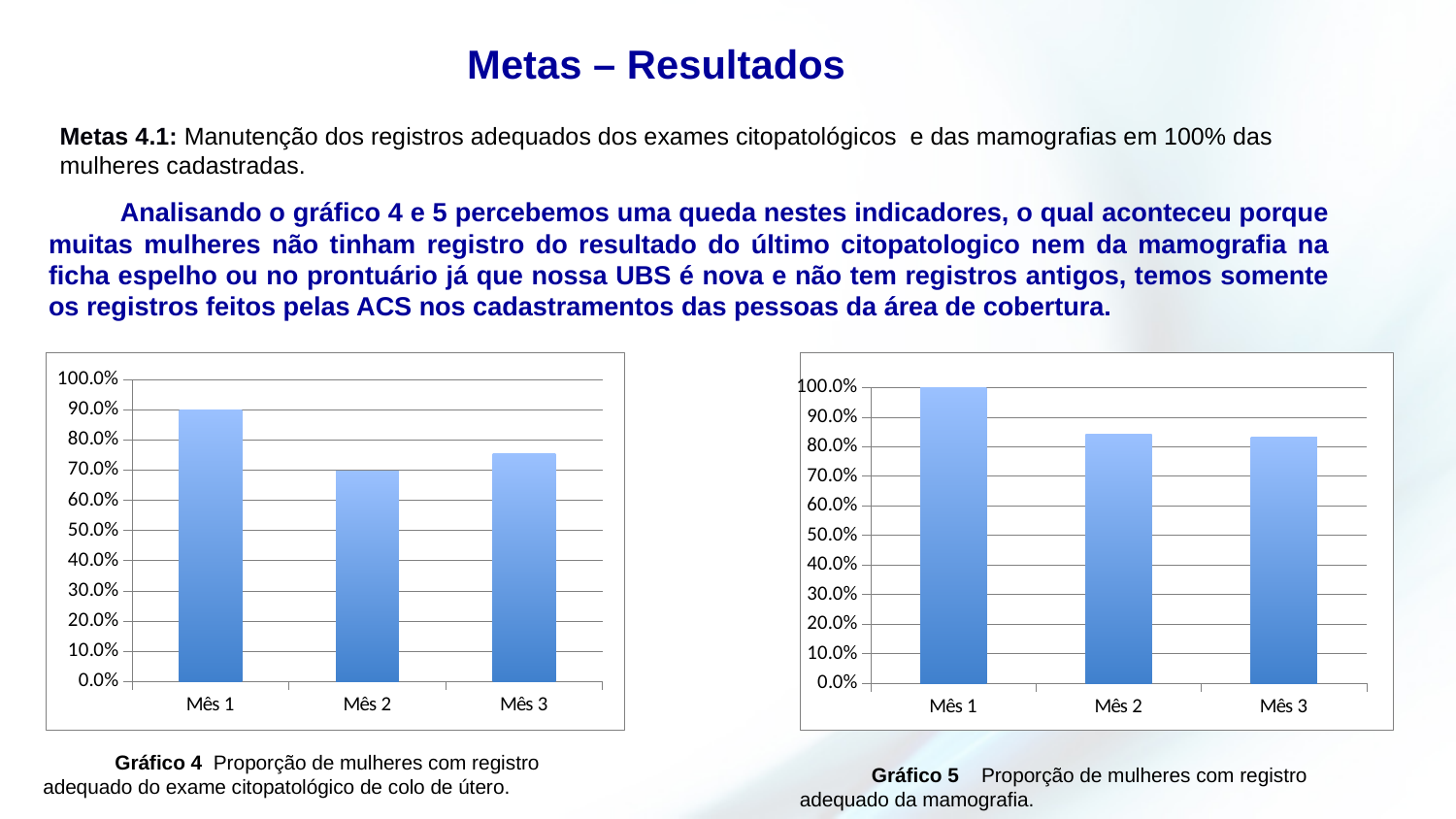
In Gráfico 5 (the right chart), which month has the highest value? Mês 1 How many categories are shown on the x axis of Gráfico 4 (the left chart)? 3 In Gráfico 4 (the left chart), which month has the lowest value? Mês 2 In Gráfico 5 (the right chart), is the value for Mês 2 greater or less than 90.0%? less What kind of chart is Gráfico 4 (the left chart)? bar chart In Gráfico 4 (the left chart), which month has the highest value? Mês 1 How many categories are shown on the x axis of Gráfico 5 (the right chart)? 3 In Gráfico 4 (the left chart), is the value for Mês 3 greater or less than 80.0%? less In Gráfico 4 (the left chart), which is larger, the value for Mês 1 or the value for Mês 3? Mês 1 In Gráfico 4 (the left chart), what is the value for Mês 1? 90.0% In Gráfico 5 (the right chart), what is the value for Mês 1? 100.0%